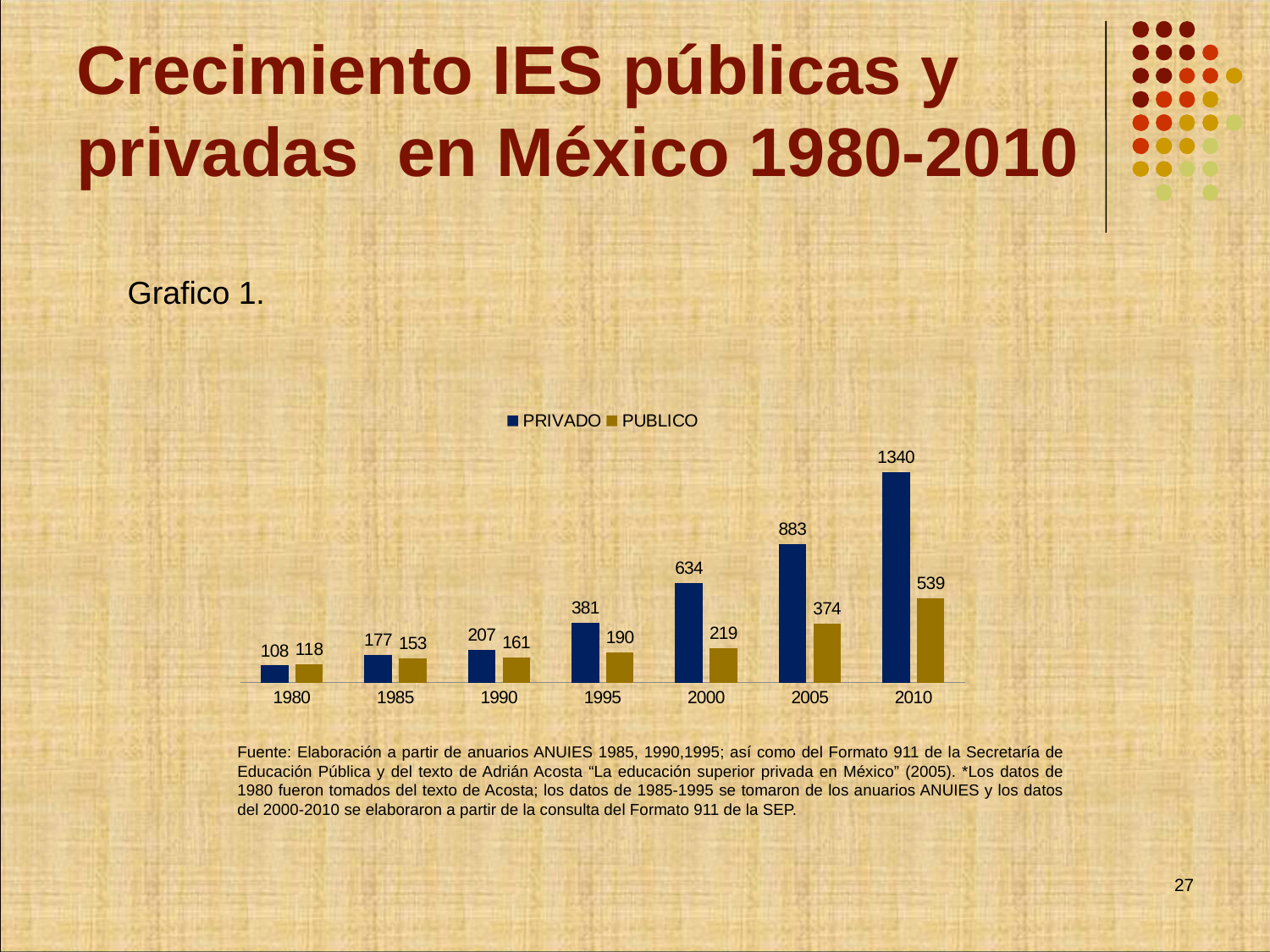
What is the PUBLICO value for 1995? 190 Which year has the lowest PRIVADO value? 1980 Which year has the highest PUBLICO value? 2010 How many series does the legend list? 2 How many years are shown on the x axis? 7 What is the PRIVADO value for 1980? 108 Do the PRIVADO values rise or fall from 1980 to 2010? Rise What is the difference between the PRIVADO and PUBLICO values in 2005? 509 What is the PRIVADO value for 2010? 1340 Which is larger in 1980, PRIVADO or PUBLICO? PUBLICO What kind of chart is shown? Bar chart What colour are the PUBLICO bars? Gold/brown